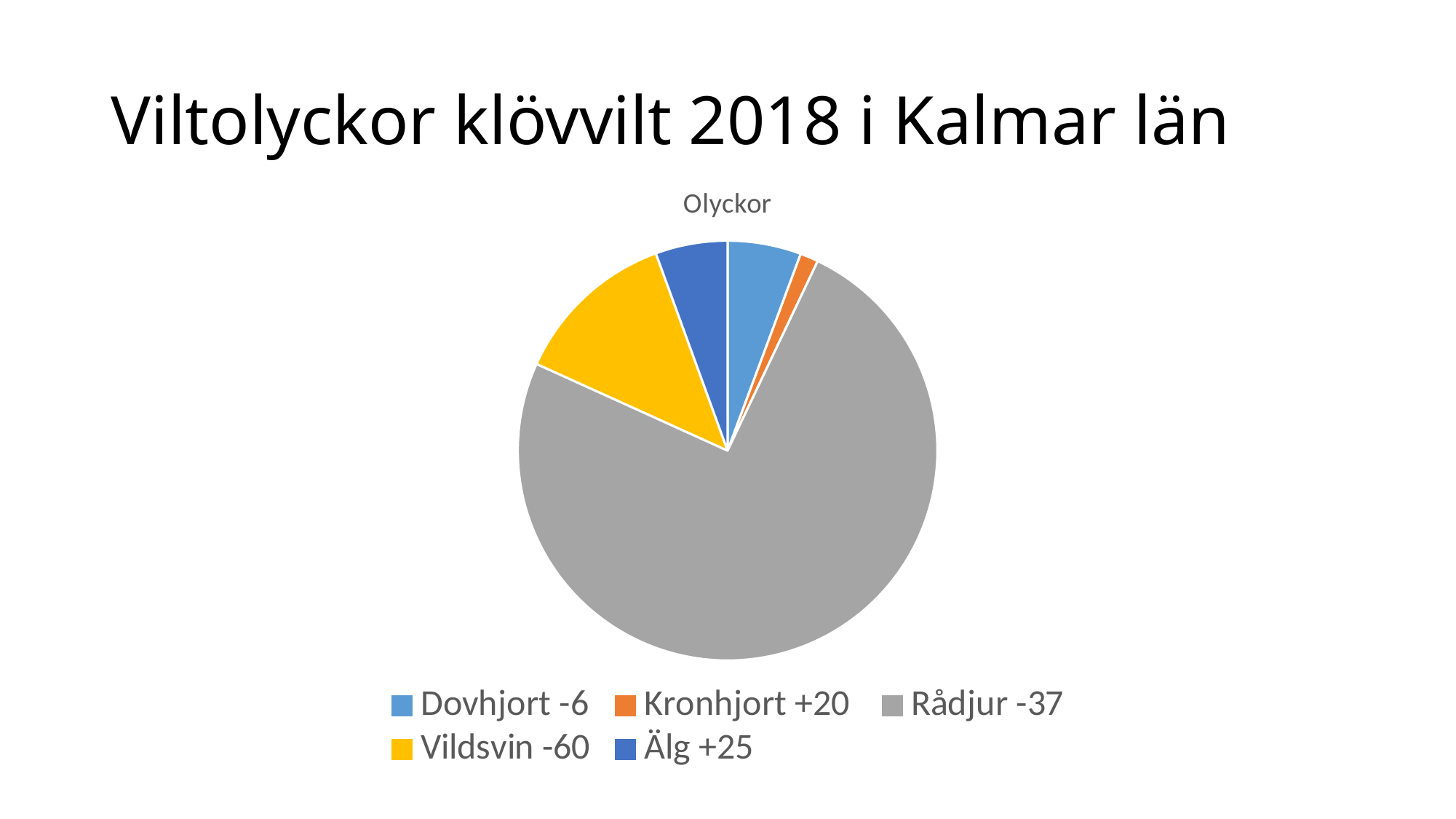
Does the Rådjur -37 slice take up more or less than half of the pie? more Which slice is larger, Dovhjort -6 or Kronhjort +20? Dovhjort -6 Which slice is larger, Vildsvin -60 or Älg +25? Vildsvin -60 Which category has the largest slice of the pie? Rådjur -37 How many entries does the legend list? 5 What is the title of the chart? Olyckor What colour is the Vildsvin -60 slice? yellow How many slices does the pie chart have? 5 What kind of chart is shown on the slide? pie chart Which category has the smallest slice of the pie? Kronhjort +20